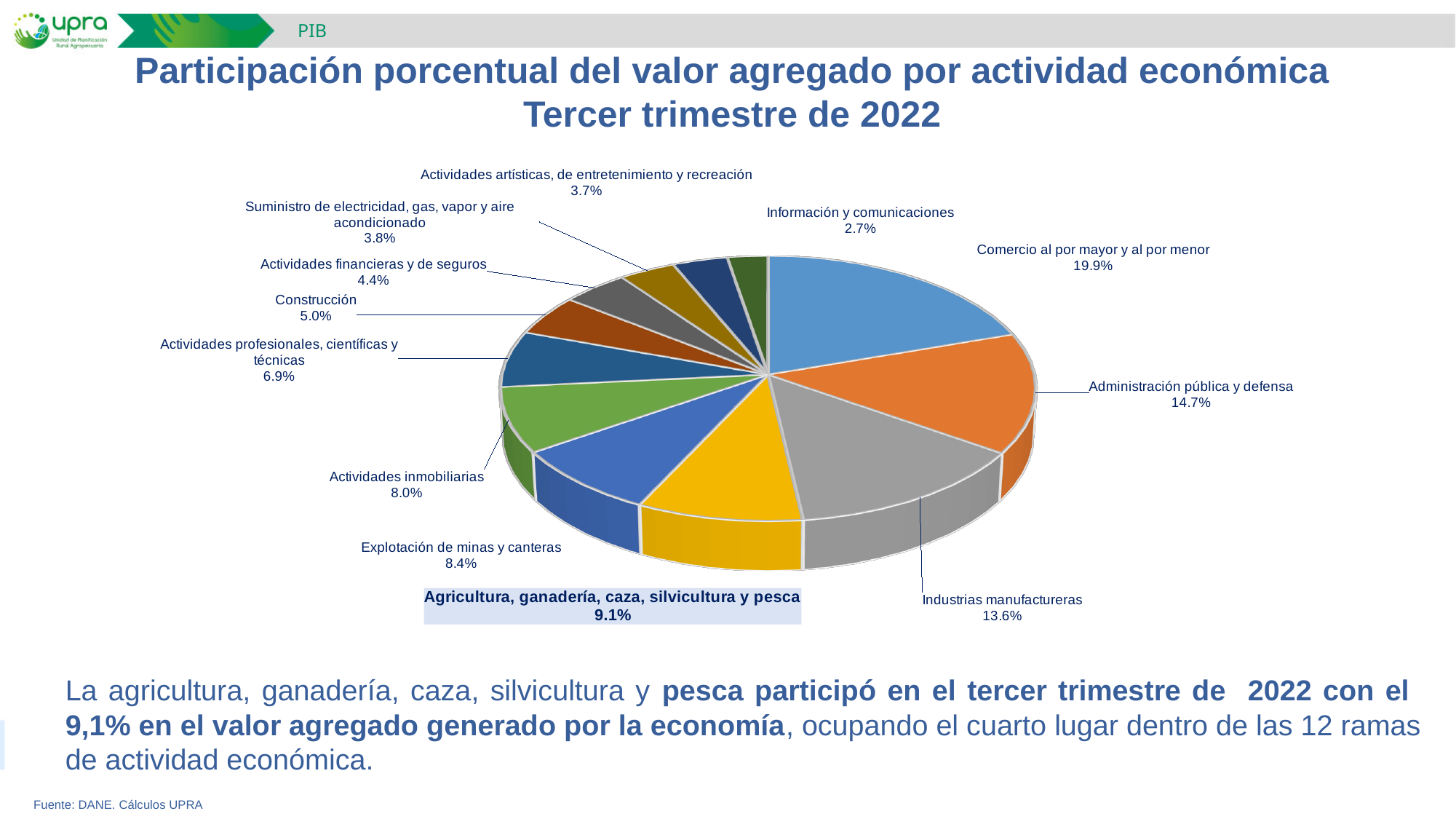
What is the share of Industrias manufactureras? 13.6% What is the difference in percentage points between Agricultura, ganadería, caza, silvicultura y pesca and Explotación de minas y canteras? 0.7 percentage points What is the share of Agricultura, ganadería, caza, silvicultura y pesca? 9.1% How many slices does the pie chart have? 12 Which has a larger share, Explotación de minas y canteras or Actividades inmobiliarias? Explotación de minas y canteras What is the share of Comercio al por mayor y al por menor? 19.9% What is the title of the chart? Participación porcentual del valor agregado por actividad económica Tercer trimestre de 2022 What is the difference in percentage points between Comercio al por mayor y al por menor and Administración pública y defensa? 5.2 percentage points Which economic activity has the largest share of the pie? Comercio al por mayor y al por menor Which economic activity has the smallest share of the pie? Información y comunicaciones What type of chart is shown on the slide? Pie chart What is the share of Construcción? 5.0%